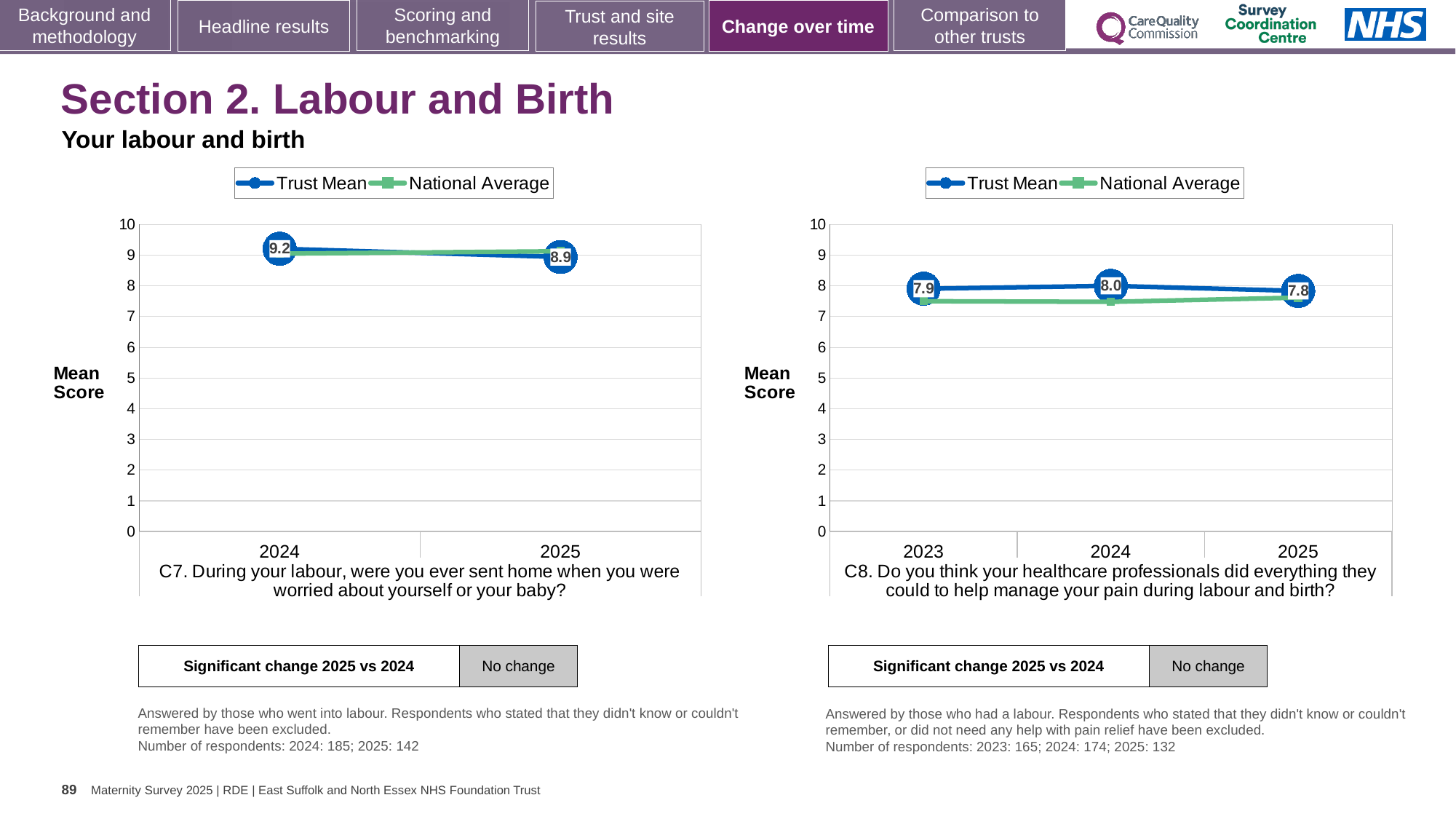
In the C8 chart (right), which year has the highest Trust Mean? 2024 What type of chart is the C8 chart (right)? line chart In the C8 chart (right), what is the Trust Mean for 2024? 8.0 In the C7 chart (left), what is the Trust Mean for 2025? 8.9 In the C7 chart (left), what is the Trust Mean for 2024? 9.2 In the C7 chart (left), how many years are shown on the x axis? 2 In the C7 chart (left), what is the difference between the Trust Mean for 2024 and 2025? 0.3 In the C8 chart (right), is the National Average for 2023 greater or less than 8? less In the C8 chart (right), what is the Trust Mean for 2025? 7.8 In the C8 chart (right), how many series does the legend list? 2 In the C8 chart (right), what is the Trust Mean for 2023? 7.9 In the C7 chart (left), does the Trust Mean rise or fall from 2024 to 2025? fall